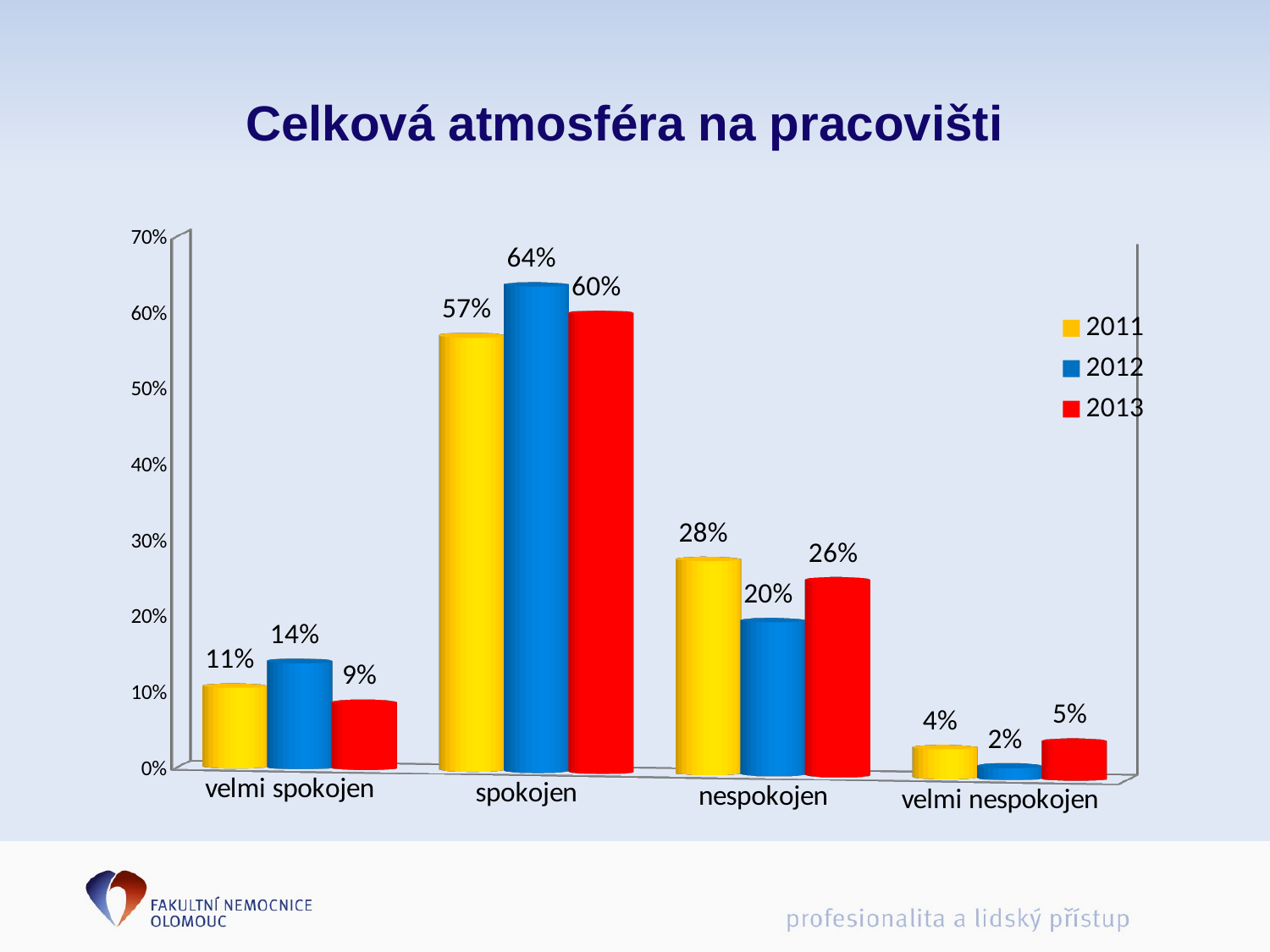
What kind of chart is shown on the slide? bar chart How many series does the legend list? 3 Which category has the highest value for 2013? spokojen What is the title of the chart? Celková atmosféra na pracovišti What is the value for 'spokojen' in 2012? 64% How many categories are shown on the x axis? 4 What is the value for 'velmi nespokojen' in 2013? 5% Which is larger for 'velmi spokojen': the 2012 value or the 2013 value? 2012 What is the difference between the 2012 and 2013 values for 'spokojen'? 4% What is the difference between the 2011 and 2013 values for 'nespokojen'? 2% Which category has the lowest value for 2012? velmi nespokojen What is the value for 'nespokojen' in 2011? 28%